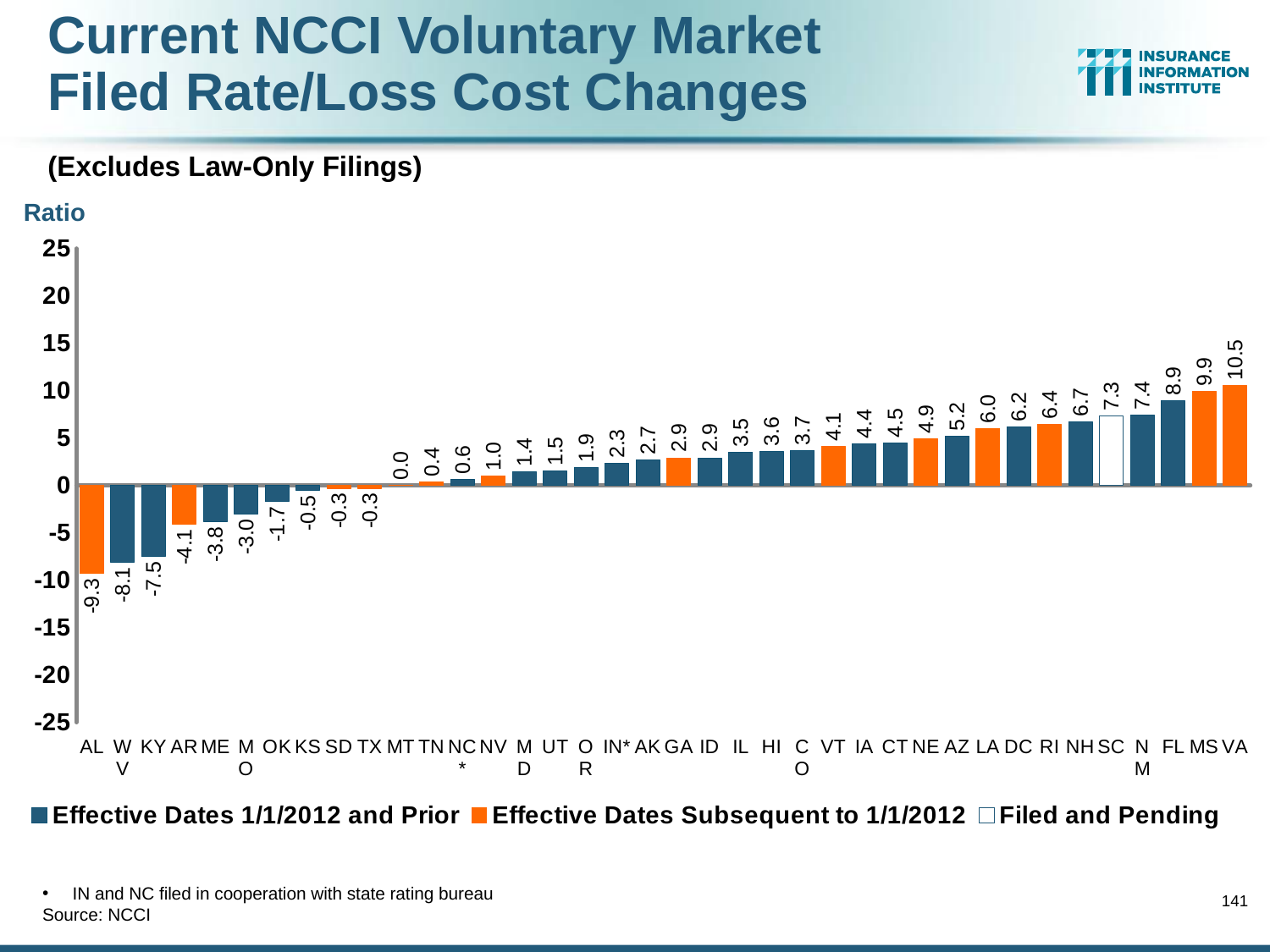
Which legend entry is shown with a white (unfilled) bar? Filed and Pending What kind of chart is this? bar chart Is the value for KY greater or less than -5? less What is the difference between the values for VA and MS? 0.6 Which state has the lowest value? AL How many states are shown on the x axis? 38 How many series does the legend list? 3 What is the value for SC? 7.3 What is the value for AL? -9.3 What is the value for VA? 10.5 Which is larger, the value for FL or the value for NH? FL Which state has the highest value? VA